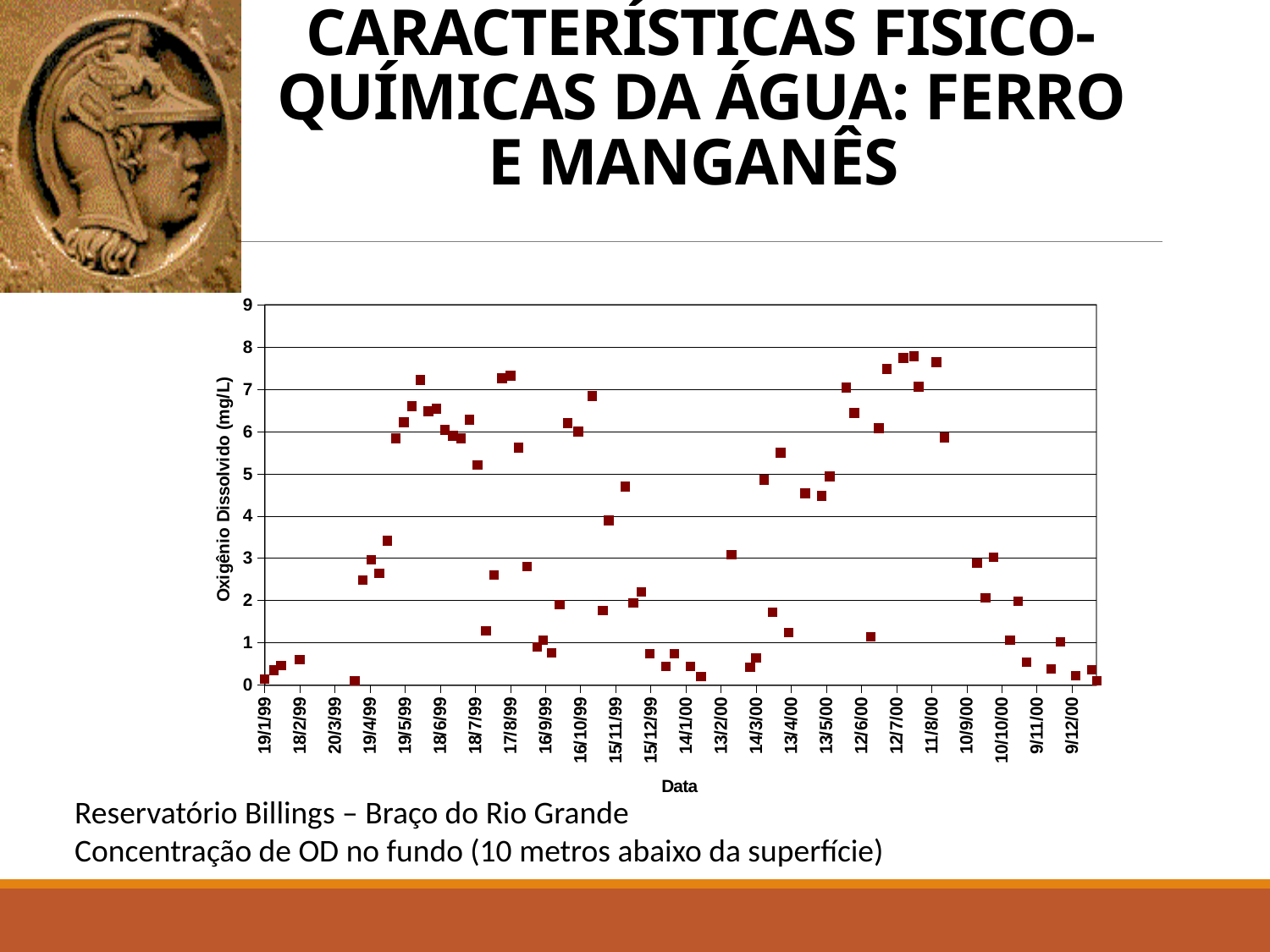
What is the label of the horizontal axis of the chart? Data Which is larger: the value at the 19/1/99 tick or the value at the 15/11/99 tick? 15/11/99 Do the values generally rise or fall between 19/1/99 and 19/5/99? rise Is the highest point on the chart, near 12/7/00, greater or less than 7? greater What is the label of the vertical axis of the chart? Oxigênio Dissolvido (mg/L) Is the value of the first point, at 19/1/99, greater or less than 1? less Is the point plotted at the 15/11/99 tick greater or less than 3? greater What kind of chart is shown on the slide? scatter chart How many date labels are printed along the horizontal axis of the chart? 24 What is the highest value shown on the vertical axis of the chart? 9 Do the values generally rise or fall between 12/7/00 and 9/12/00? fall